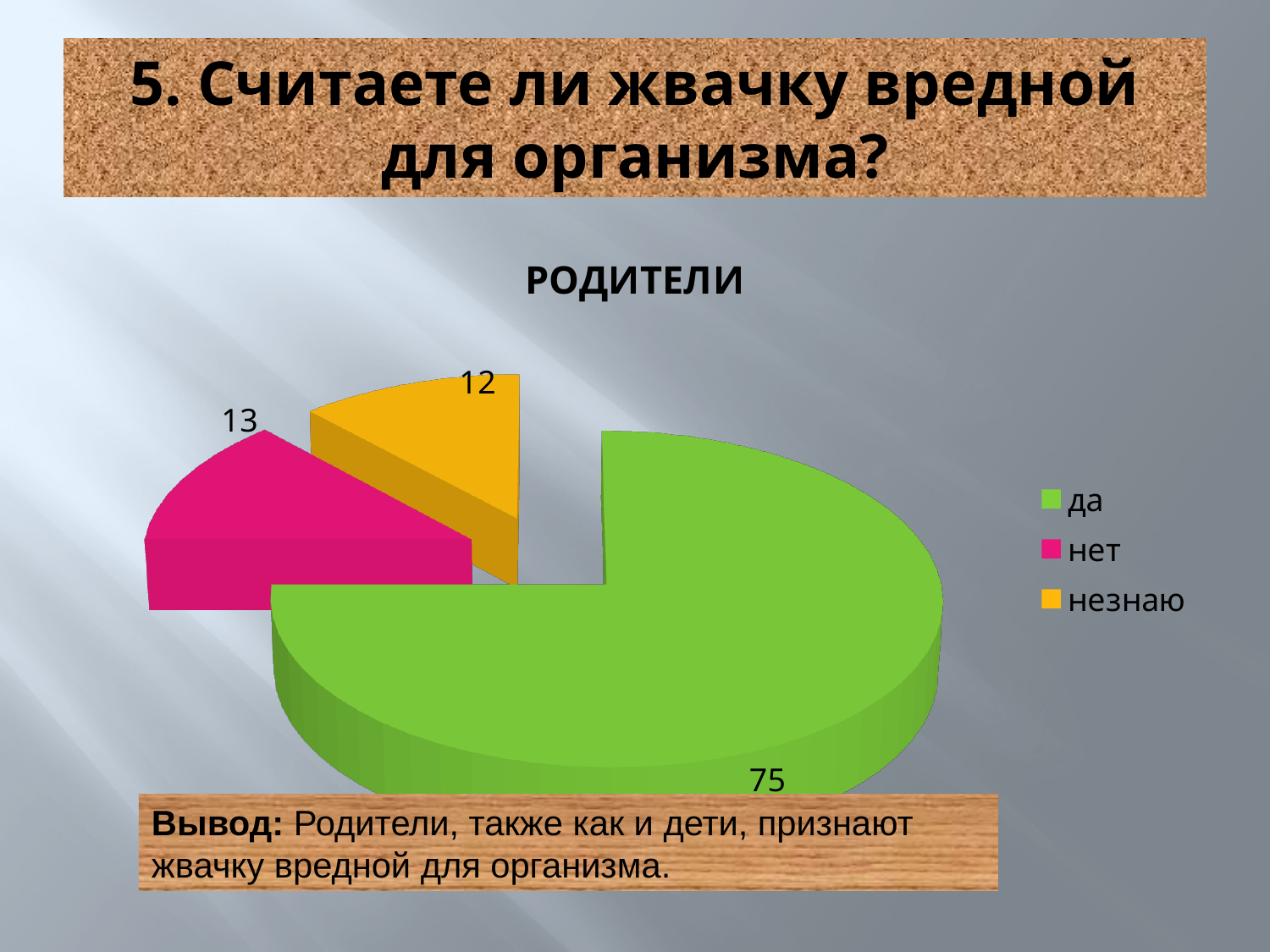
Which is larger, the value for "нет" or the value for "незнаю"? нет What is the title of the chart? РОДИТЕЛИ What is the difference between the values for "да" and "нет"? 62 What is the total of all slices in the pie chart? 100 What is the value for "незнаю"? 12 Which category has the smallest slice? незнаю Which category has the largest slice? да What type of chart is shown on the slide? pie chart What share of the pie does the "да" slice represent? 75% What is the value for "да"? 75 What is the value for "нет"? 13 How many categories does the pie chart have? 3